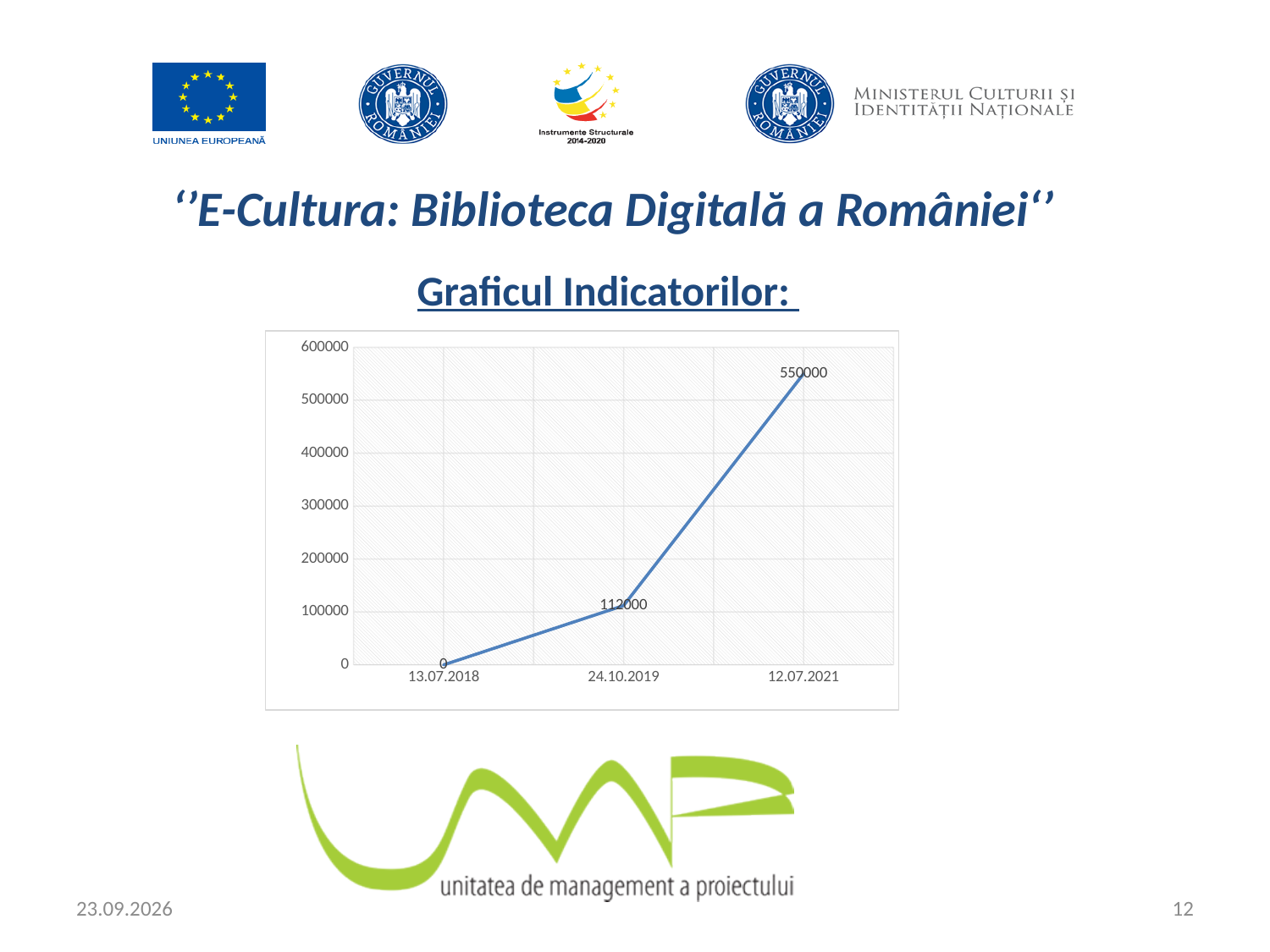
Which is larger, the value for 24.10.2019 or the value for 12.07.2021? 12.07.2021 Do the values rise or fall from 13.07.2018 to 12.07.2021? rise What is the value plotted for 12.07.2021? 550000 What is the value plotted for 24.10.2019? 112000 Which date has the highest value on the chart? 12.07.2021 What is the value plotted for 13.07.2018? 0 How many data points are plotted on the chart? 3 What is the difference between the values for 12.07.2021 and 24.10.2019? 438000 Which date has the lowest value on the chart? 13.07.2018 What kind of chart is shown on the slide? line chart Is the value for 12.07.2021 greater or less than 500000? greater What is the heading shown above the chart? Graficul Indicatorilor: